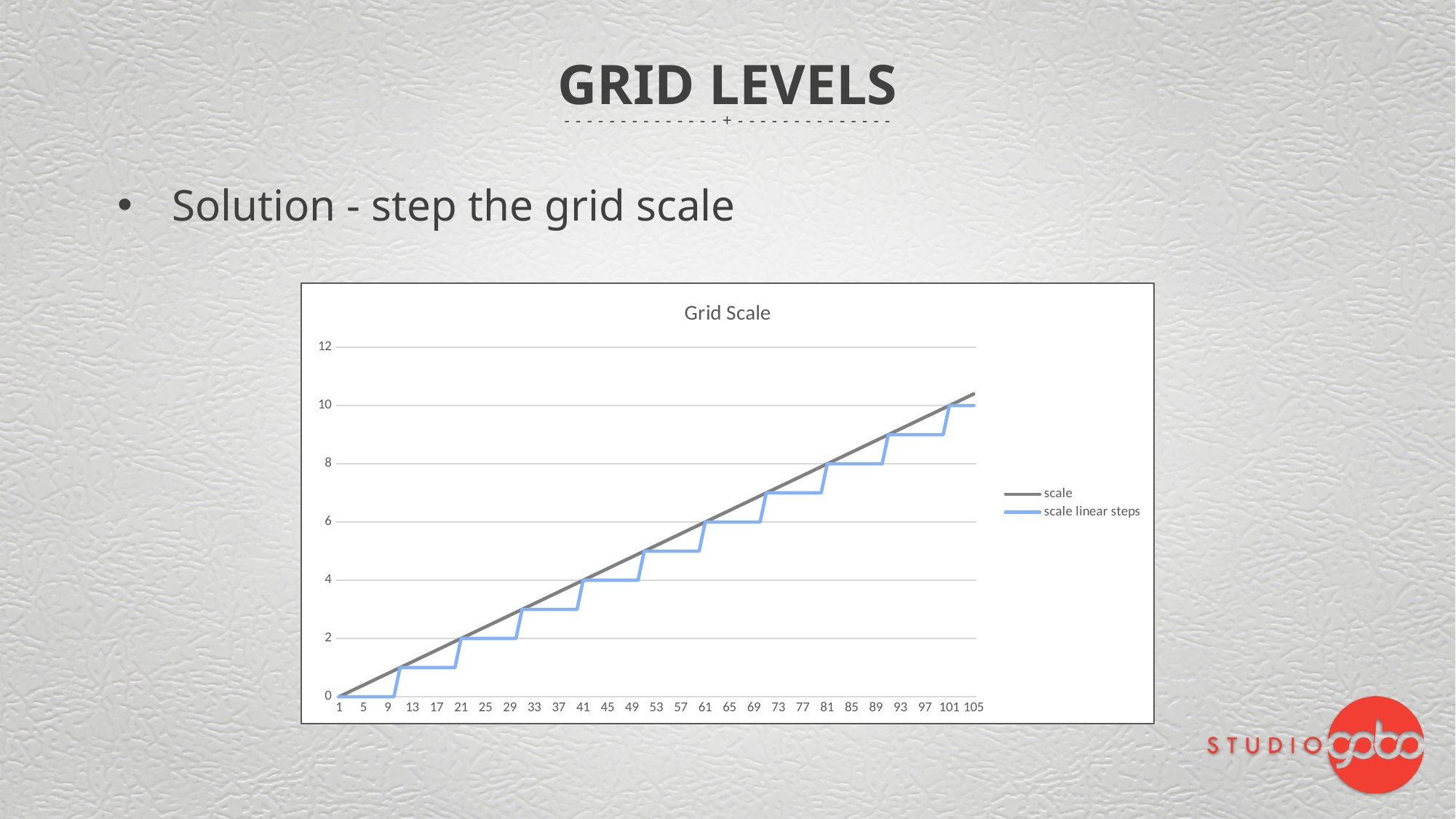
How many series does the legend of the Grid Scale chart list? 2 What is the value of the 'scale linear steps' series at x = 65? 6 What is the title of the chart on the slide? Grid Scale Is the value of the 'scale' series at x = 53 greater or less than 6? less What is the highest value shown on the y axis of the Grid Scale chart? 12 What are the two series named in the legend of the Grid Scale chart? scale, scale linear steps At x = 57, which series has the higher value, 'scale' or 'scale linear steps'? scale What is the value of the 'scale linear steps' series at x = 105? 10 What is the value of the 'scale linear steps' series at x = 1? 0 Is the value of the 'scale' series at x = 105 greater or less than 10? greater What kind of chart is the Grid Scale chart? line chart Do the values of the 'scale' series rise or fall as x increases along the x axis? rise